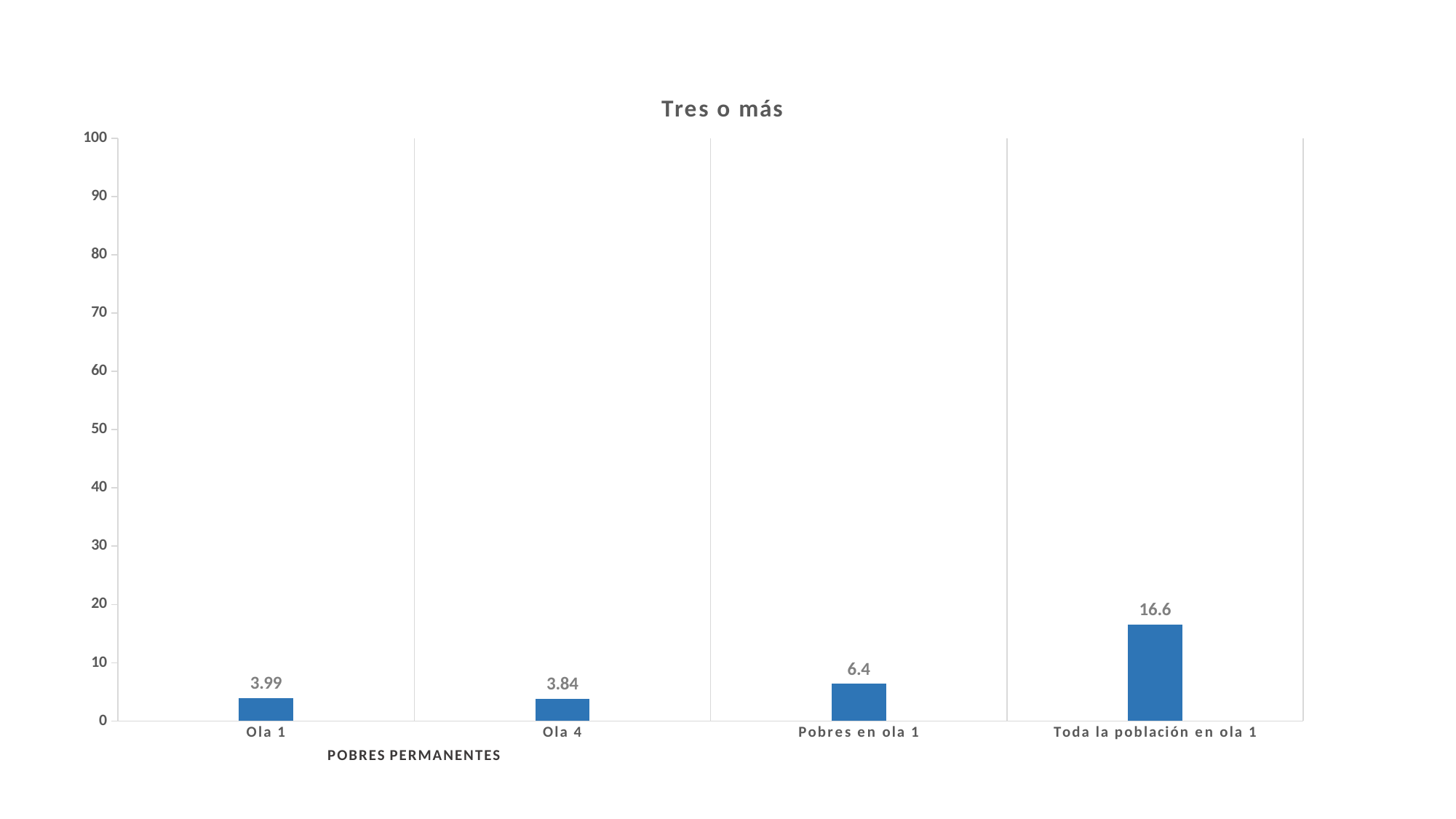
Which is larger, the value for Pobres en ola 1 or the value for Ola 4? Pobres en ola 1 What is the value for Toda la población en ola 1? 16.6 Is the value for Toda la población en ola 1 greater or less than 10? greater What is the difference between the values for Toda la población en ola 1 and Pobres en ola 1? 10.2 What is the value for Pobres en ola 1? 6.4 What is the difference between the values for Ola 1 and Ola 4? 0.15 What is the value for Ola 1? 3.99 What is the value for Ola 4? 3.84 What kind of chart is this? bar chart How many categories are shown on the x axis? 4 What is the title of the chart? Tres o más Which category has the highest value? Toda la población en ola 1